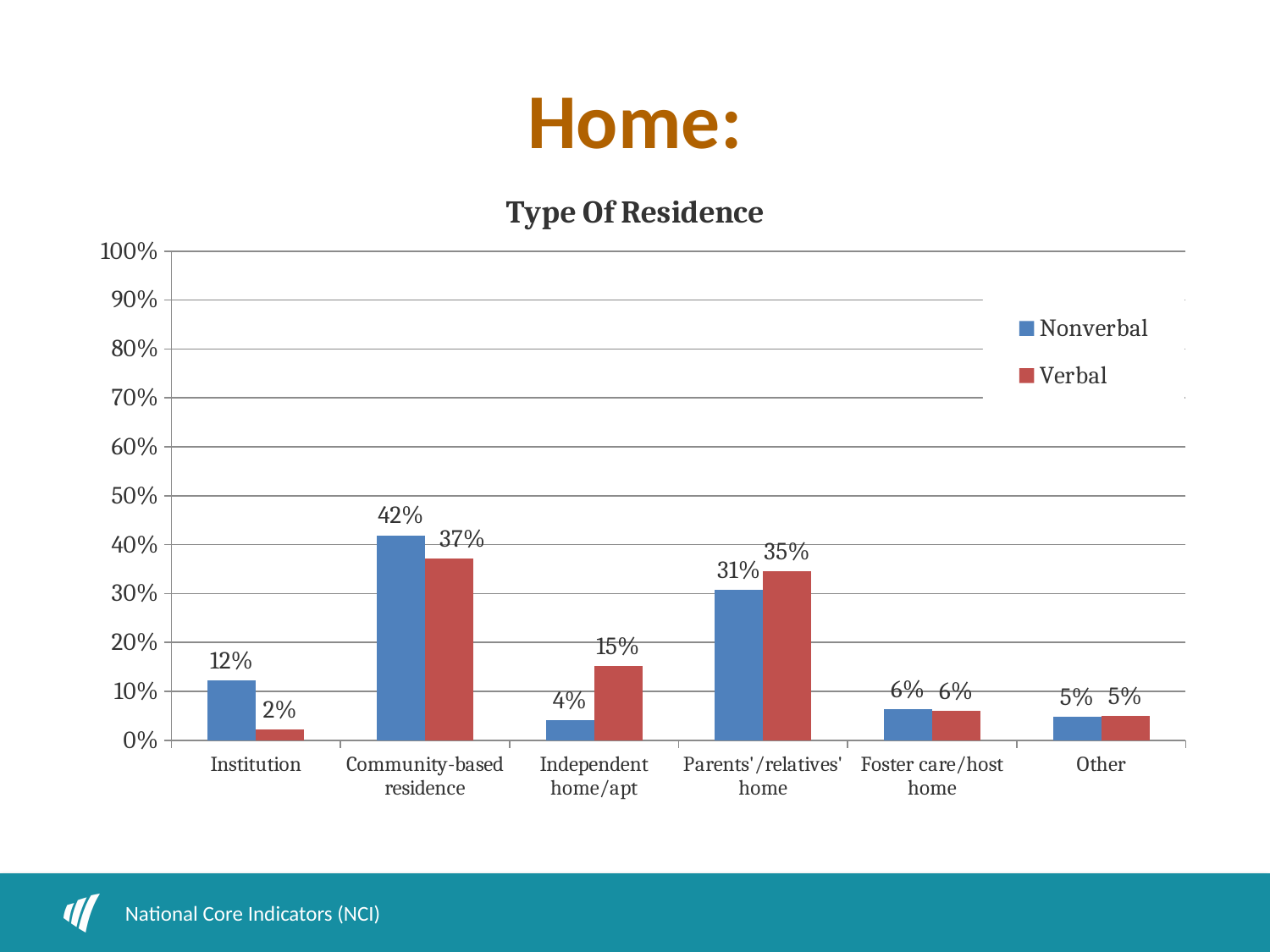
Which is larger for Parents'/relatives' home, the Nonverbal or the Verbal value? Verbal What is the difference between the Nonverbal and Verbal values for Community-based residence? 5% What is the Verbal value for Parents'/relatives' home? 35% Which category has the highest Nonverbal value? Community-based residence Is the Nonverbal value for Community-based residence greater or less than 40%? greater What kind of chart is shown? Bar chart What is the title of the chart? Type Of Residence How many residence categories are shown on the x axis? 6 Which category has the lowest Verbal value? Institution How many series does the legend list? 2 What is the Nonverbal value for Institution? 12% What is the Verbal value for Independent home/apt? 15%